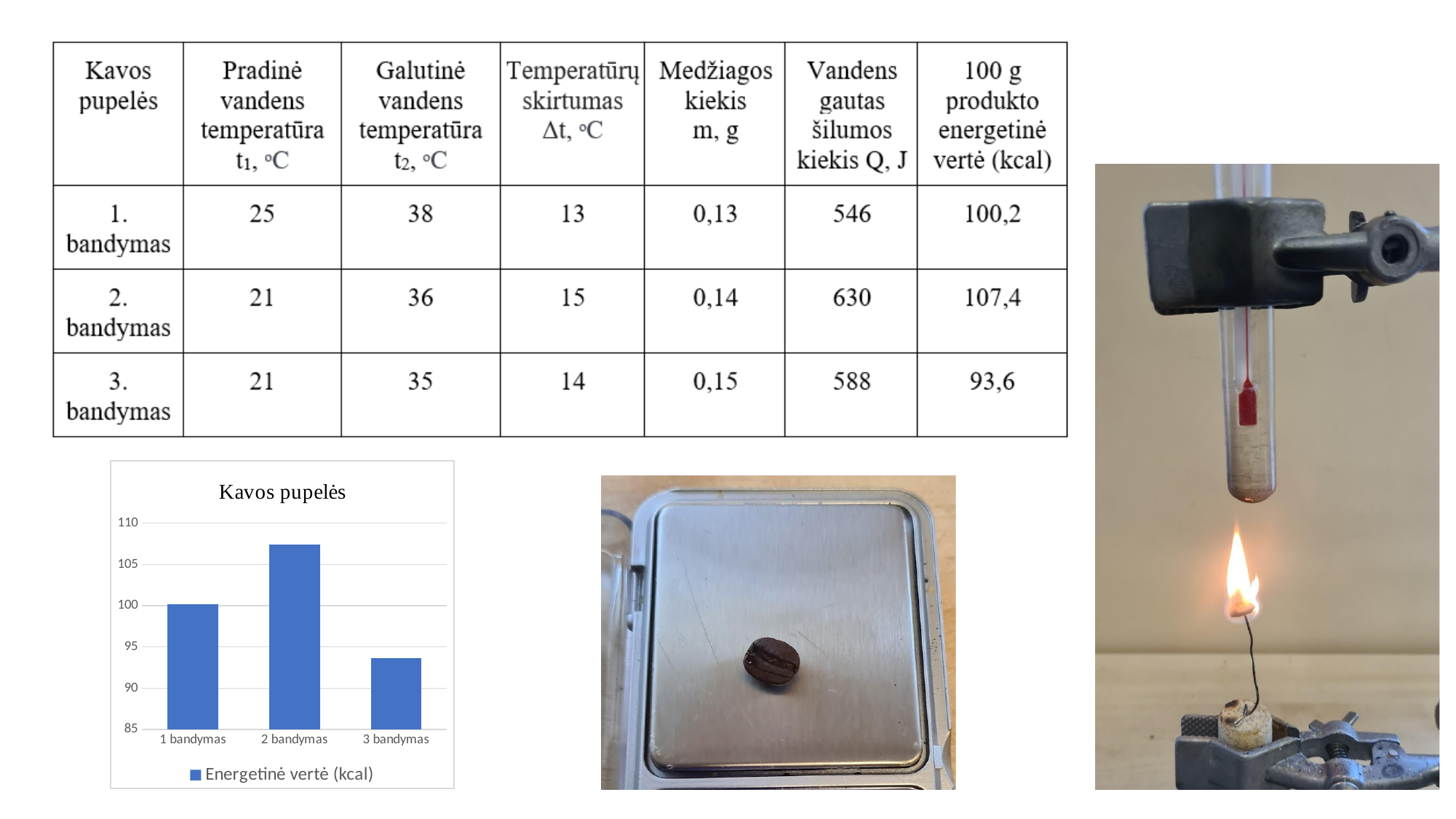
Which bandymas has the highest energetinė vertė in the chart? 2 bandymas Which is larger in the chart, the value for 1 bandymas or 3 bandymas? 1 bandymas How many series does the chart legend list? 1 What series name is shown in the chart legend? Energetinė vertė (kcal) Is the value for 2 bandymas greater or less than 105? greater How many bars (categories) does the chart show? 3 What type of chart is shown on the slide? bar chart According to the table on the slide, what is the energetinė vertė (kcal) plotted for 2 bandymas? 107,4 What is the title of the chart? Kavos pupelės Which bandymas has the lowest energetinė vertė in the chart? 3 bandymas Is the value for 3 bandymas greater or less than 95? less